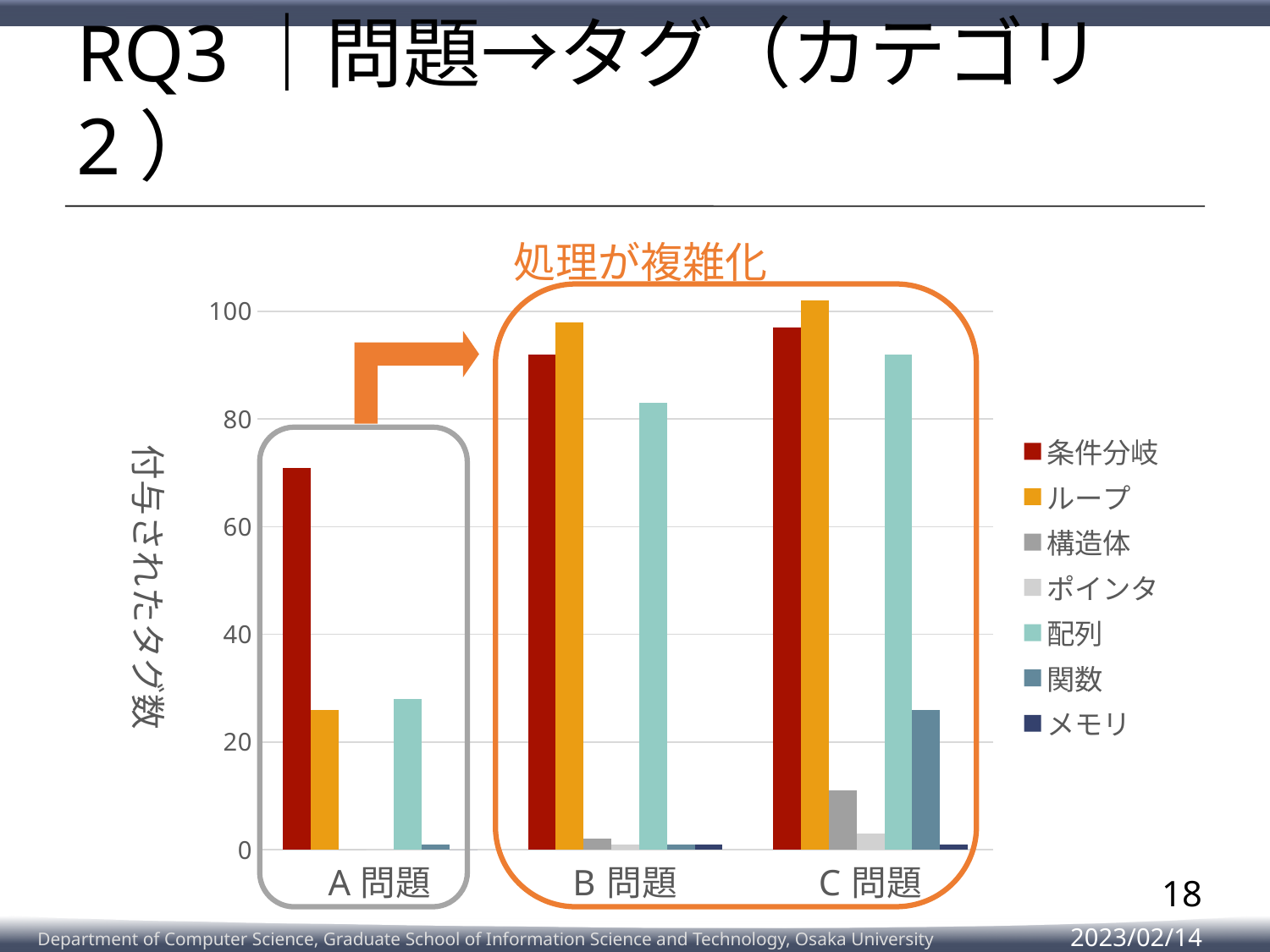
Is the value for 関数 in C 問題 greater or less than 40? less Does the 条件分岐 value rise or fall from A 問題 to C 問題? rise How many categories (問題) are shown on the x axis? 3 What is the label on the vertical axis of the chart? 付与されたタグ数 Is the value for 条件分岐 in A 問題 greater or less than 60? greater Which category has the highest 配列 value? C 問題 How many series does the legend list? 7 In B 問題, which is larger: 条件分岐 or 配列? 条件分岐 Is the value for ループ in A 問題 greater or less than 40? less What kind of chart is shown on the slide? bar chart Which category has the lowest 条件分岐 value? A 問題